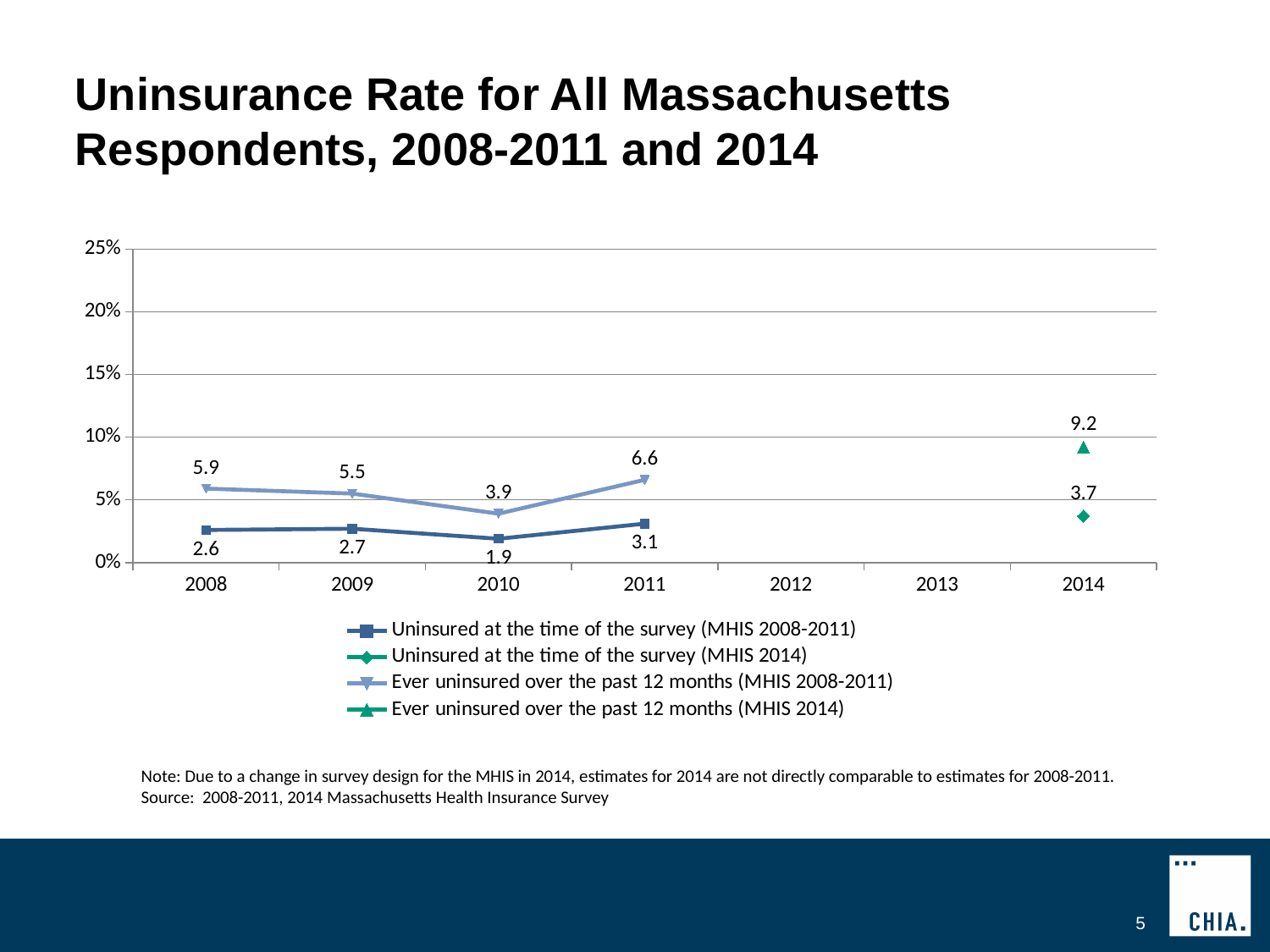
What is the value for 'Uninsured at the time of the survey (MHIS 2014)' in 2014? 3.7 Is the 'Ever uninsured over the past 12 months (MHIS 2014)' value in 2014 greater or less than 10%? less What is the value for 'Ever uninsured over the past 12 months (MHIS 2008-2011)' in 2011? 6.6 What is the value for 'Ever uninsured over the past 12 months (MHIS 2014)' in 2014? 9.2 What kind of chart is shown on the slide? line chart Which is larger: the 'Ever uninsured over the past 12 months (MHIS 2008-2011)' value in 2008 or in 2009? 2008 What is the difference between the 'Ever uninsured over the past 12 months' and 'Uninsured at the time of the survey' values in 2008? 3.3 In which year is the 'Uninsured at the time of the survey (MHIS 2008-2011)' series highest? 2011 How many years are shown on the x axis? 7 How many series does the legend list? 4 What is the value for 'Uninsured at the time of the survey (MHIS 2008-2011)' in 2010? 1.9 In which year is the 'Ever uninsured over the past 12 months (MHIS 2008-2011)' series lowest? 2010